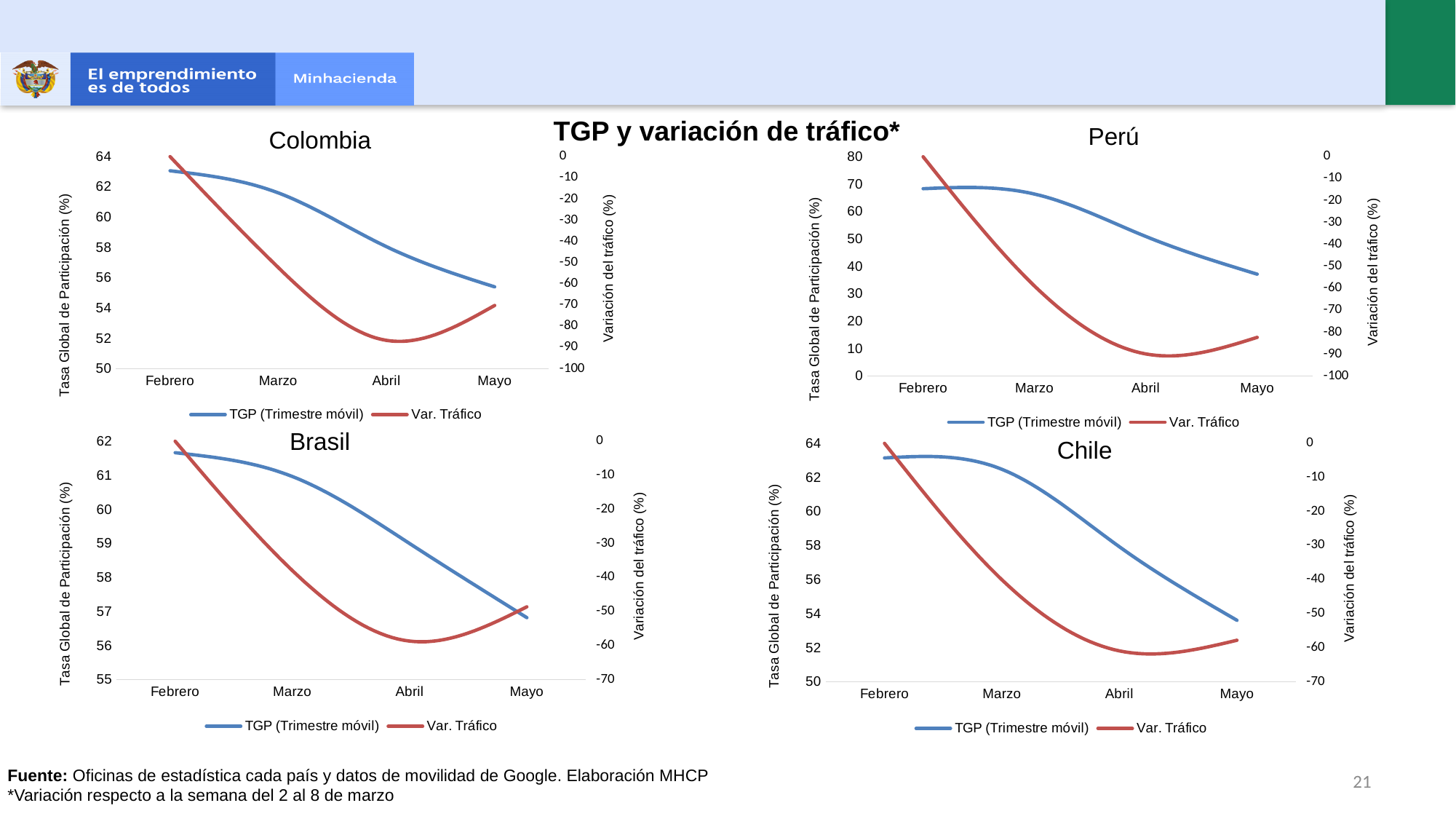
In the Chile chart, which series is drawn in red? Var. Tráfico How many months are shown on the x axis of the Colombia chart? 4 How many series does the legend of the Colombia chart list? 2 In the Perú chart, is the TGP (Trimestre móvil) value for Mayo greater or less than 40? less In the Brasil chart, which month has the highest TGP (Trimestre móvil) value? Febrero In the Brasil chart, which month has the lowest Var. Tráfico value? Abril In the Perú chart, which month has the lowest Var. Tráfico value? Abril In the Perú chart, is the TGP (Trimestre móvil) value for Febrero greater or less than 60? greater In the Colombia chart, does the TGP (Trimestre móvil) line rise or fall from Febrero to Mayo? fall What kind of chart is the Colombia chart? line chart In the Chile chart, is the TGP (Trimestre móvil) value for Mayo greater or less than 56? less